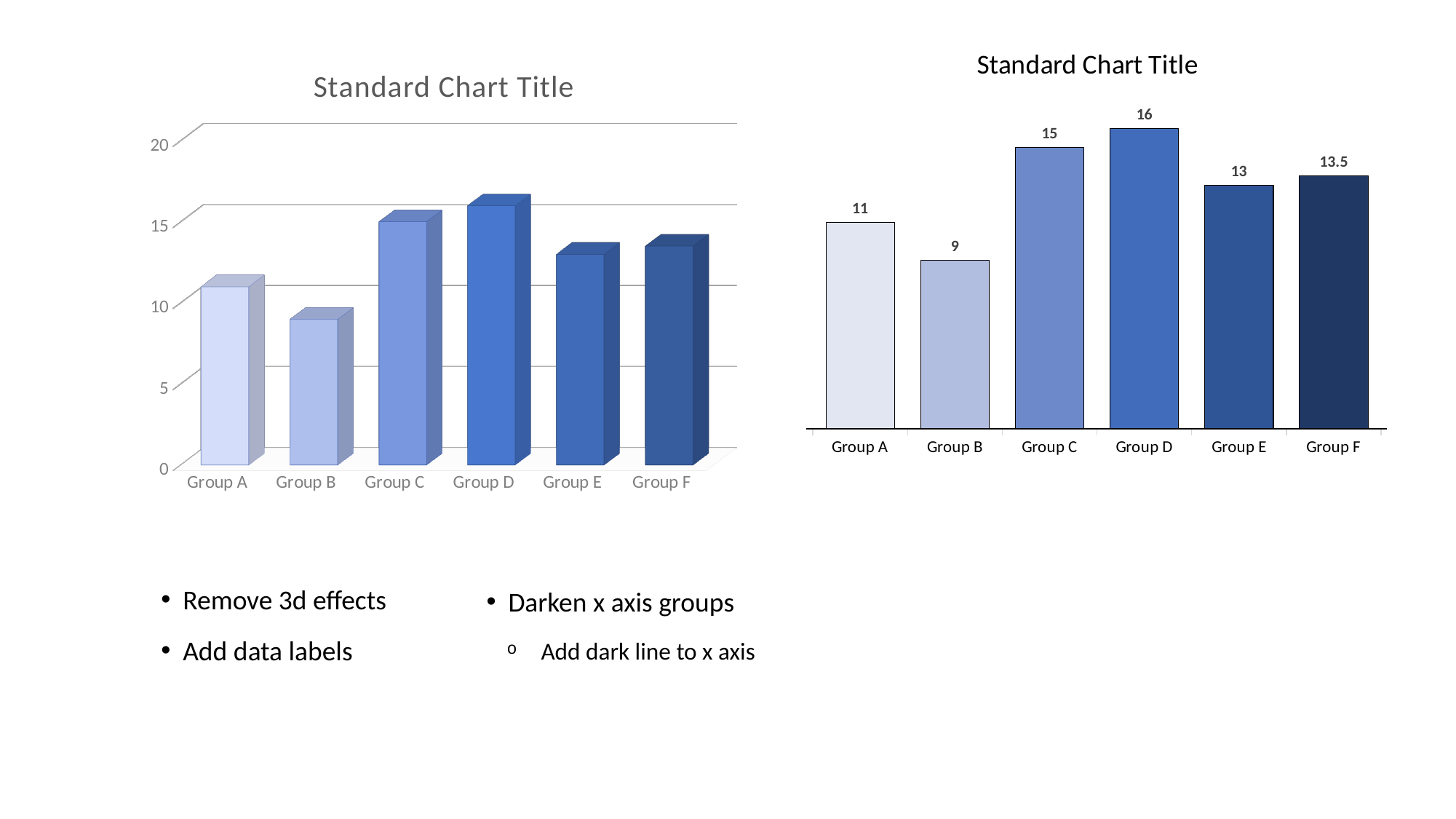
In the right-hand chart, what is the value for Group D? 16 How many groups are shown on the x axis of the right-hand chart? 6 In the right-hand chart, what is the value for Group B? 9 In the right-hand chart, which group has the lowest value? Group B In the right-hand chart, which group has the highest value? Group D In the left-hand chart, is the value for Group D greater or less than 15? greater In the right-hand chart, what is the difference between the values for Group D and Group B? 7 In the right-hand chart, what is the value for Group F? 13.5 What is the title of the right-hand chart? Standard Chart Title What kind of chart is the left-hand chart? bar chart In the right-hand chart, which is larger, the value for Group A or the value for Group E? Group E In the left-hand chart, is the value for Group B greater or less than 10? less